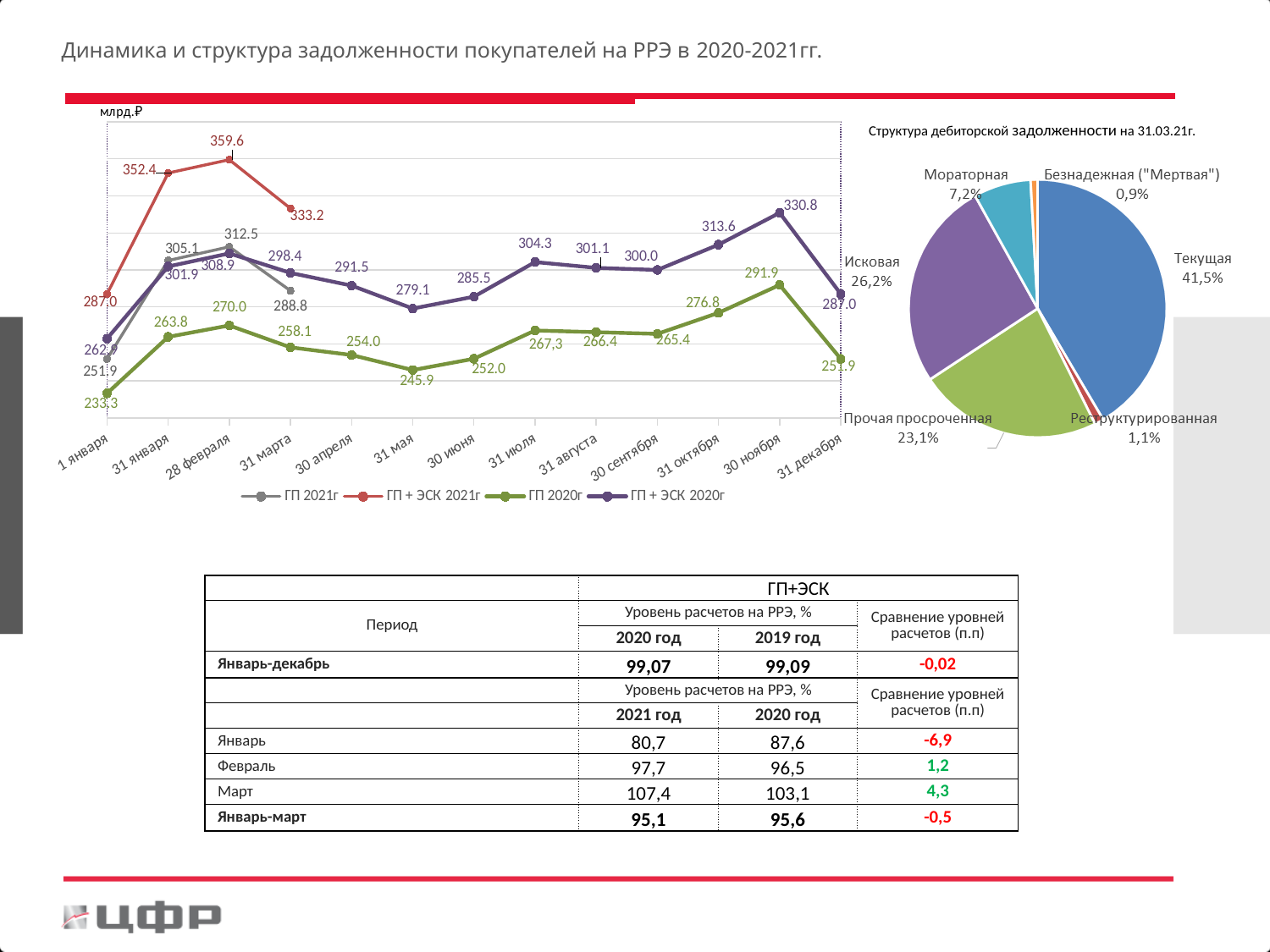
In the left line chart, on which date does ГП + ЭСК 2020г reach its highest value? 30 ноября In the left line chart, does ГП + ЭСК 2021г rise or fall from 28 февраля to 31 марта? Fall In the left line chart, what is the lowest value of the ГП 2020г series? 233.3 In the left line chart, what is the value of ГП + ЭСК 2021г on 28 февраля? 359.6 What kind of chart is the chart on the left of the slide (млрд.₽)? Line chart How many series does the legend of the left line chart list? 4 How many slices does the pie chart 'Структура дебиторской задолженности на 31.03.21г.' have? 6 In the pie chart 'Структура дебиторской задолженности на 31.03.21г.', which category has the largest share? Текущая In the left line chart, what is the value of ГП 2020г on 31 мая? 245.9 In the left line chart, what is the difference between ГП + ЭСК 2021г and ГП + ЭСК 2020г on 31 марта? 34.8 In the left line chart, which is larger on 31 марта: ГП 2021г or ГП + ЭСК 2020г? ГП + ЭСК 2020г In the pie chart 'Структура дебиторской задолженности на 31.03.21г.', what is the share of Исковая? 26,2%